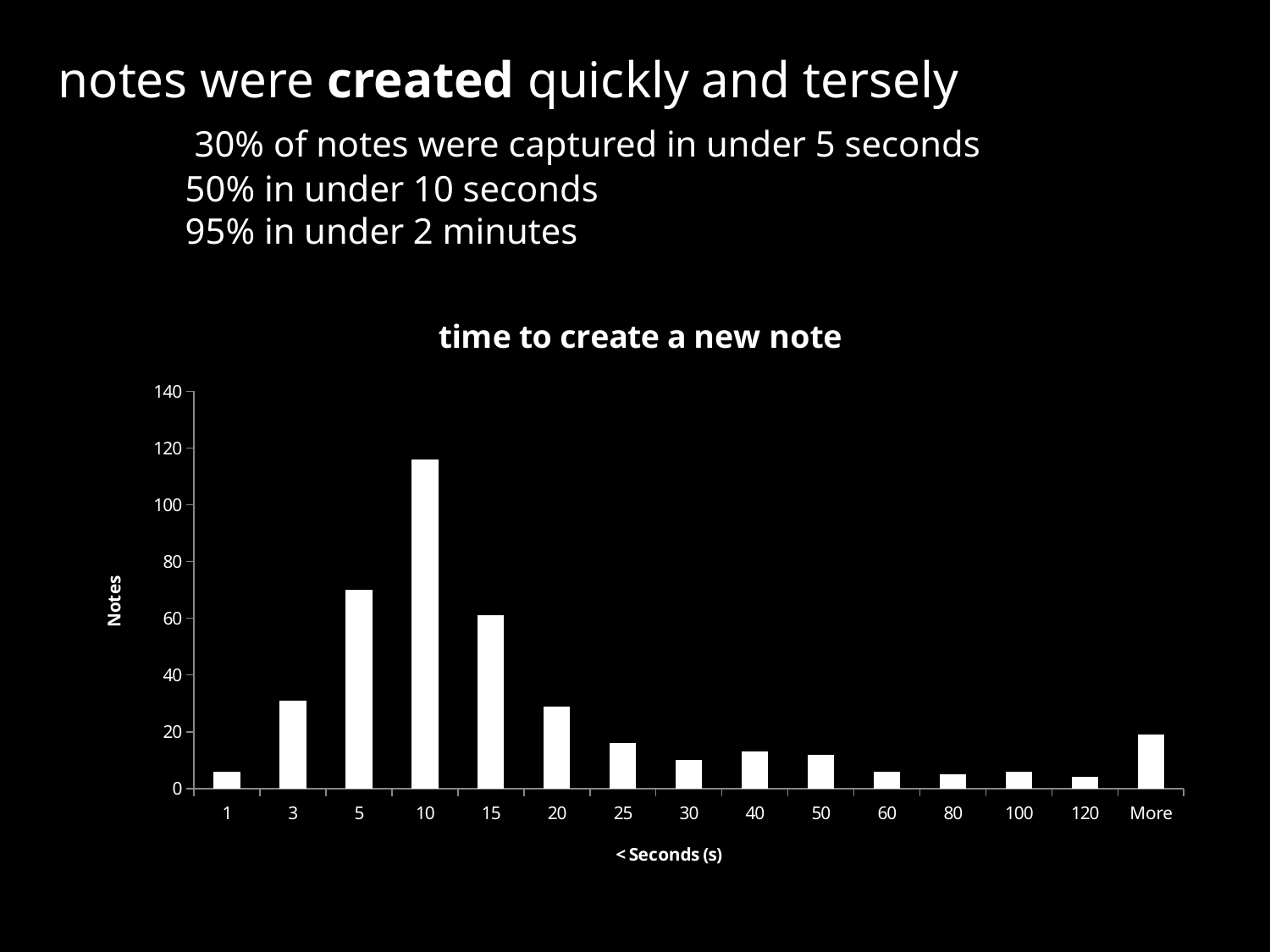
Is the value for the 3 category greater or less than 20? greater Which category has the highest number of notes? 10 Which has more notes, the 5 category or the 15 category? 5 What is the label of the y axis? Notes Which has more notes, the 25 category or the 30 category? 25 Is the value for the 5 category greater or less than 80? less Is the value for the 10 category greater or less than 100? greater How many categories are shown on the x axis of the chart? 15 What kind of chart is shown on the slide? bar chart What is the title of the chart? time to create a new note